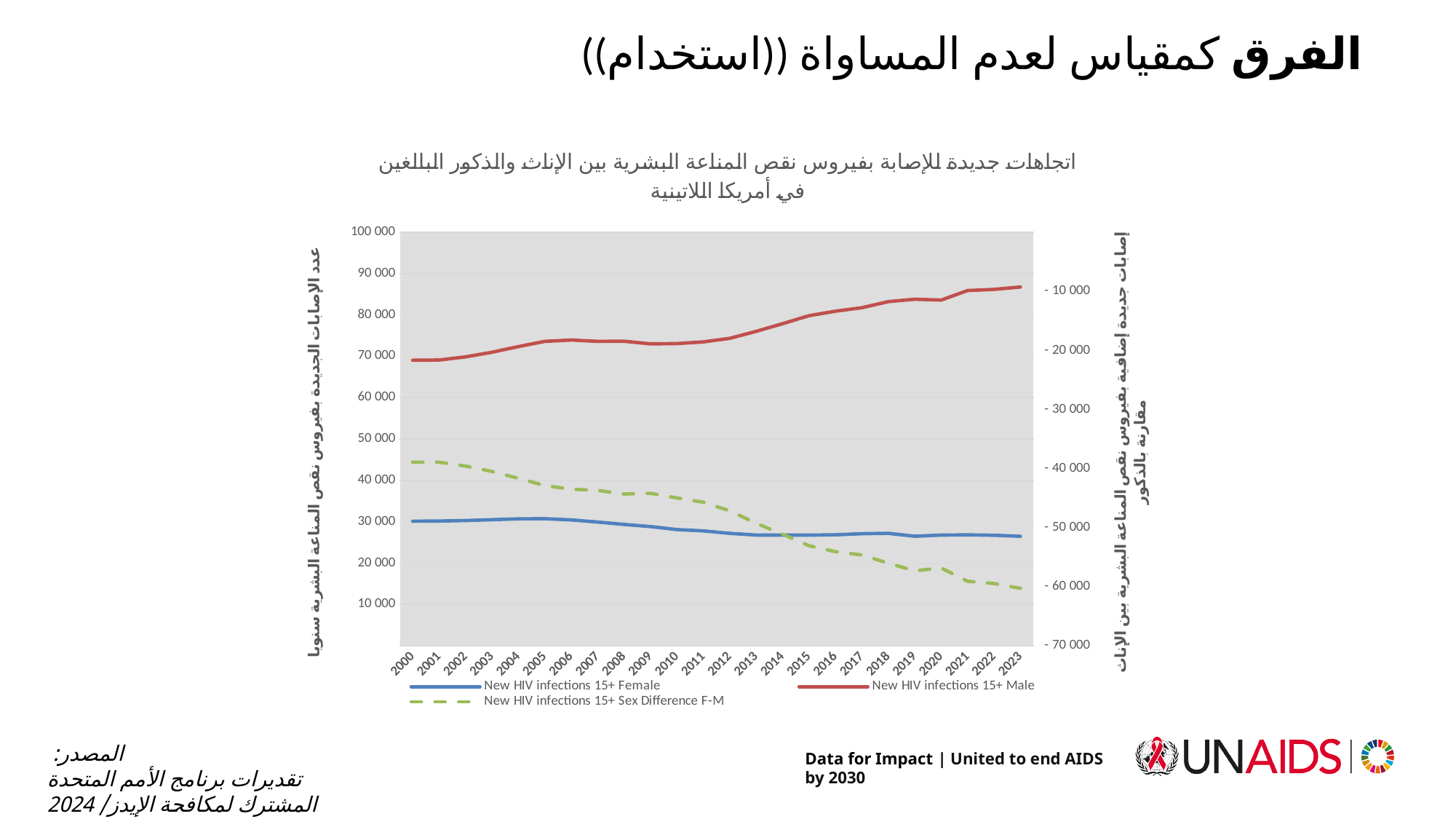
What kind of chart is shown on the slide? Line chart Does the 'New HIV infections 15+ Female' line rise or fall from 2000 to 2023? Fall What is the first year shown on the x axis? 2000 In 2023, which is larger: 'New HIV infections 15+ Male' or 'New HIV infections 15+ Female'? New HIV infections 15+ Male Is the value for 'New HIV infections 15+ Female' in 2023 greater or less than 30 000 on the left axis? less How many years are shown along the x axis of the chart? 24 Is the value for 'New HIV infections 15+ Male' in 2023 greater or less than 80 000 on the left axis? greater Which series is drawn as a dashed line in the chart? New HIV infections 15+ Sex Difference F-M Does the 'New HIV infections 15+ Male' line rise or fall from 2000 to 2023? Rise Is the value for 'New HIV infections 15+ Female' in 2000 greater or less than 40 000 on the left axis? less How many series does the chart legend list? 3